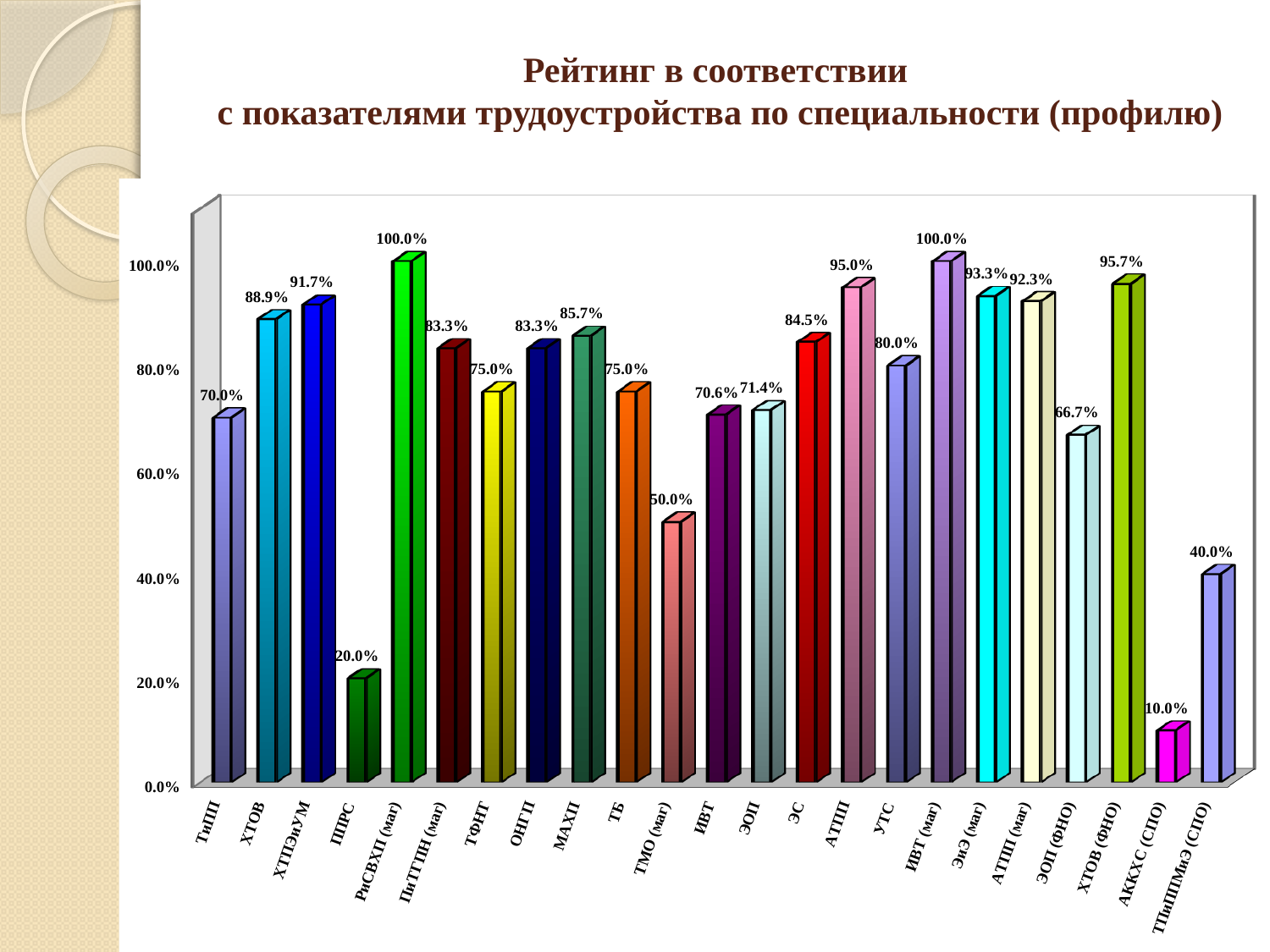
What is the value for ТМО (маг)? 50.0% What kind of chart is shown on the slide? Bar chart What is the value for ХТОВ (ФНО)? 95.7% What is the difference between the values for АТПП and УТС? 15.0% What is the title of the chart? Рейтинг в соответствии с показателями трудоустройства по специальности (профилю) What is the value for ЭиЭ (маг)? 93.3% Which category has the lowest value? АККХС (СПО) How many categories are shown on the x axis? 23 Which two categories share the highest value of 100.0%? РиСВХП (маг) and ИВТ (маг) Which is larger, the value for ХТОВ or the value for ХТПЭиУМ? ХТПЭиУМ What is the value for ППРС? 20.0% What is the difference between the values for ТПиППМиЭ (СПО) and АККХС (СПО)? 30.0%